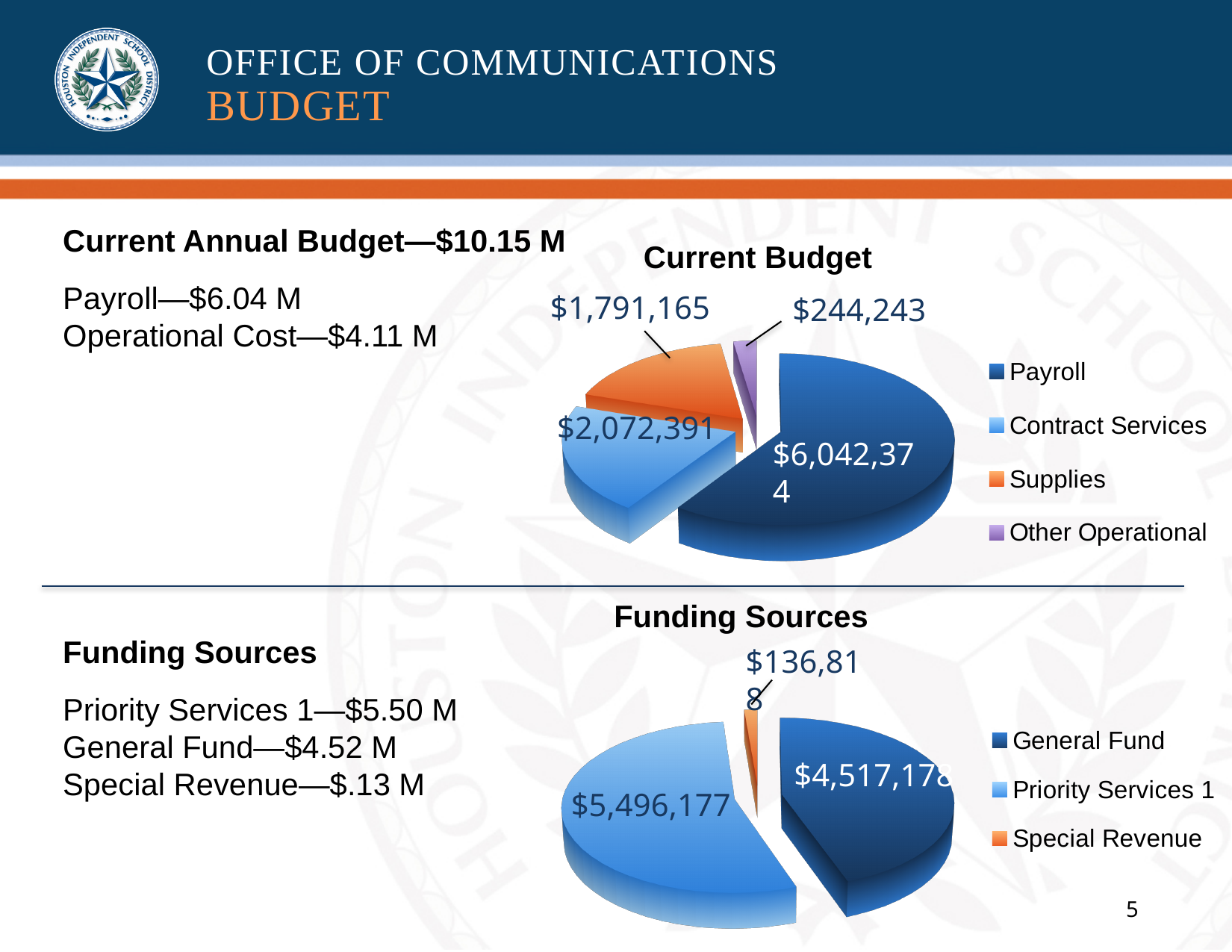
What type of chart is the Funding Sources chart? Pie chart In the Funding Sources chart, what is the value for Priority Services 1? $5,496,177 In the Funding Sources chart, what is the value for Special Revenue? $136,818 In the Funding Sources chart, what is the difference between Priority Services 1 and General Fund? $978,999 In the Current Budget chart, what is the difference between Payroll and Contract Services? $3,969,983 In the Current Budget chart, what is the value for Other Operational? $244,243 In the Current Budget chart, how many categories does the legend list? 4 In the Current Budget chart, what is the value for Payroll? $6,042,374 In the Funding Sources chart, which is larger, General Fund or Priority Services 1? Priority Services 1 In the Current Budget chart, which category has the largest slice? Payroll In the Current Budget chart, what is the value for Supplies? $1,791,165 In the Current Budget chart, which category has the smallest slice? Other Operational